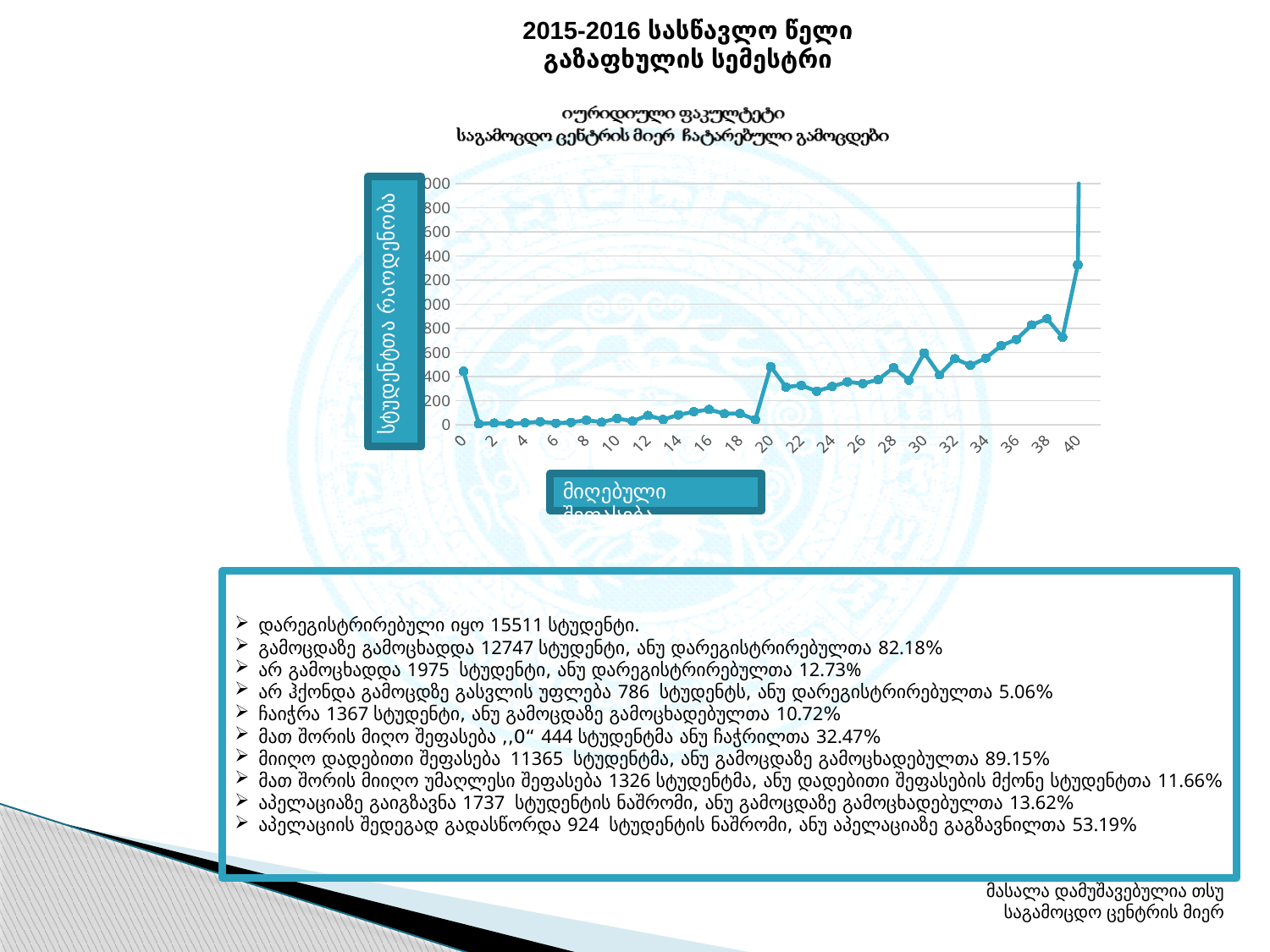
Which has the larger value: score 0 or score 10? score 0 Between score 20 and score 40, does the line generally rise or fall? rise Which has the larger value: score 38 or score 28? score 38 What is the label of the vertical axis of the chart? სტუდენტთა რაოდენობა Is the value for score 30 greater or less than 400? greater Is the value for score 0 greater or less than 200? greater What is the label shown below the horizontal axis of the chart? მიღებული შეფასება Is the value for score 4 greater or less than 200? less At which score on the x axis does the line reach its highest value? 40 What kind of chart is shown on the slide? line chart